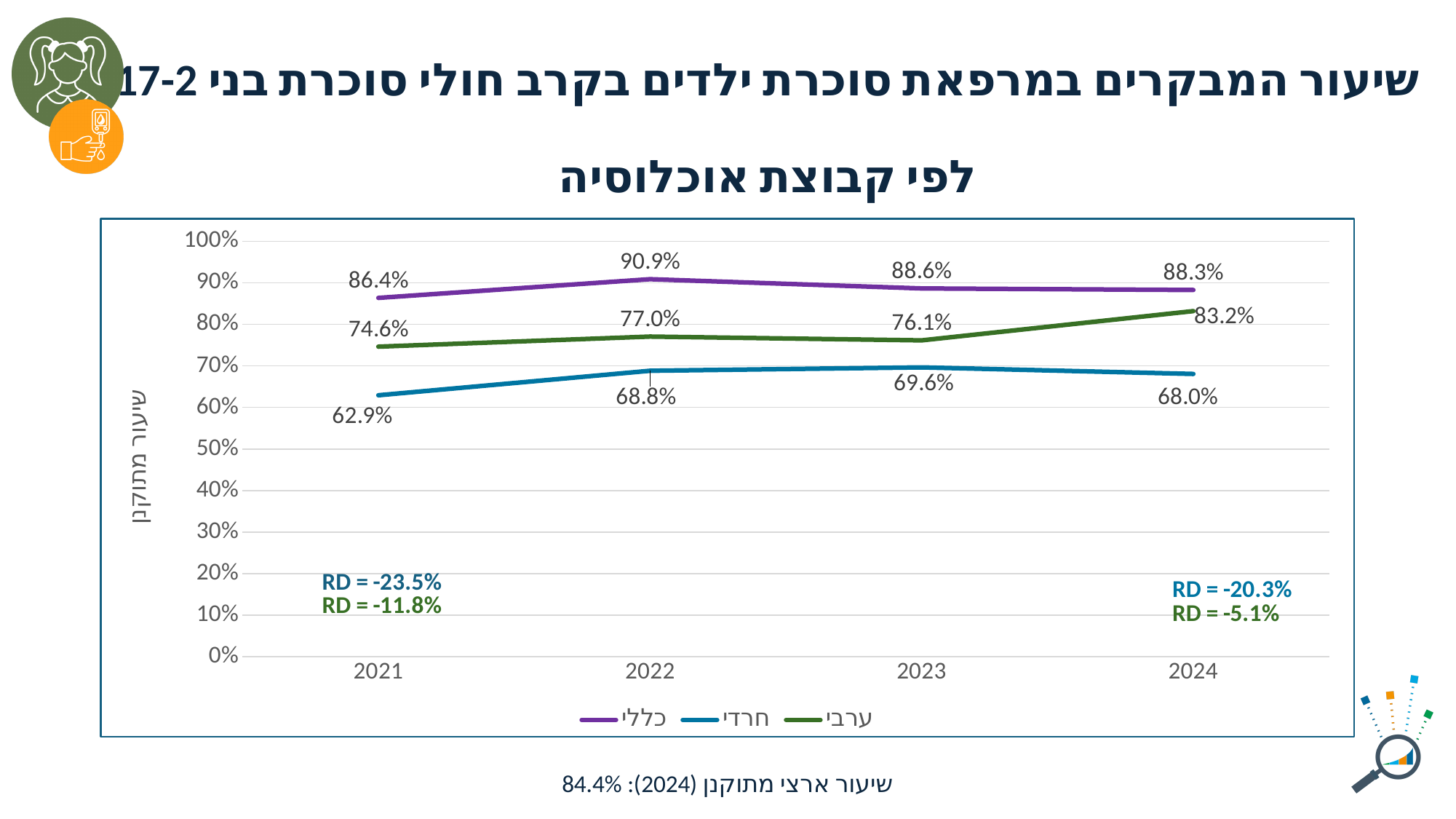
What is the value for the ערבי series in 2024? 83.2% In which year is the חרדי series lowest? 2021 How many series does the legend list? 3 Which series has the larger value in 2023, חרדי or ערבי? ערבי In which year is the כללי series highest? 2022 What is the value for the חרדי series in 2021? 62.9% Does the ערבי series rise or fall from 2023 to 2024? rise How many years are shown on the x axis? 4 What is the difference between the ערבי value in 2024 and in 2023? 7.1% What is the value for the כללי series in 2022? 90.9% What type of chart is shown on the slide? line chart Which colour is used for the כללי series line? purple